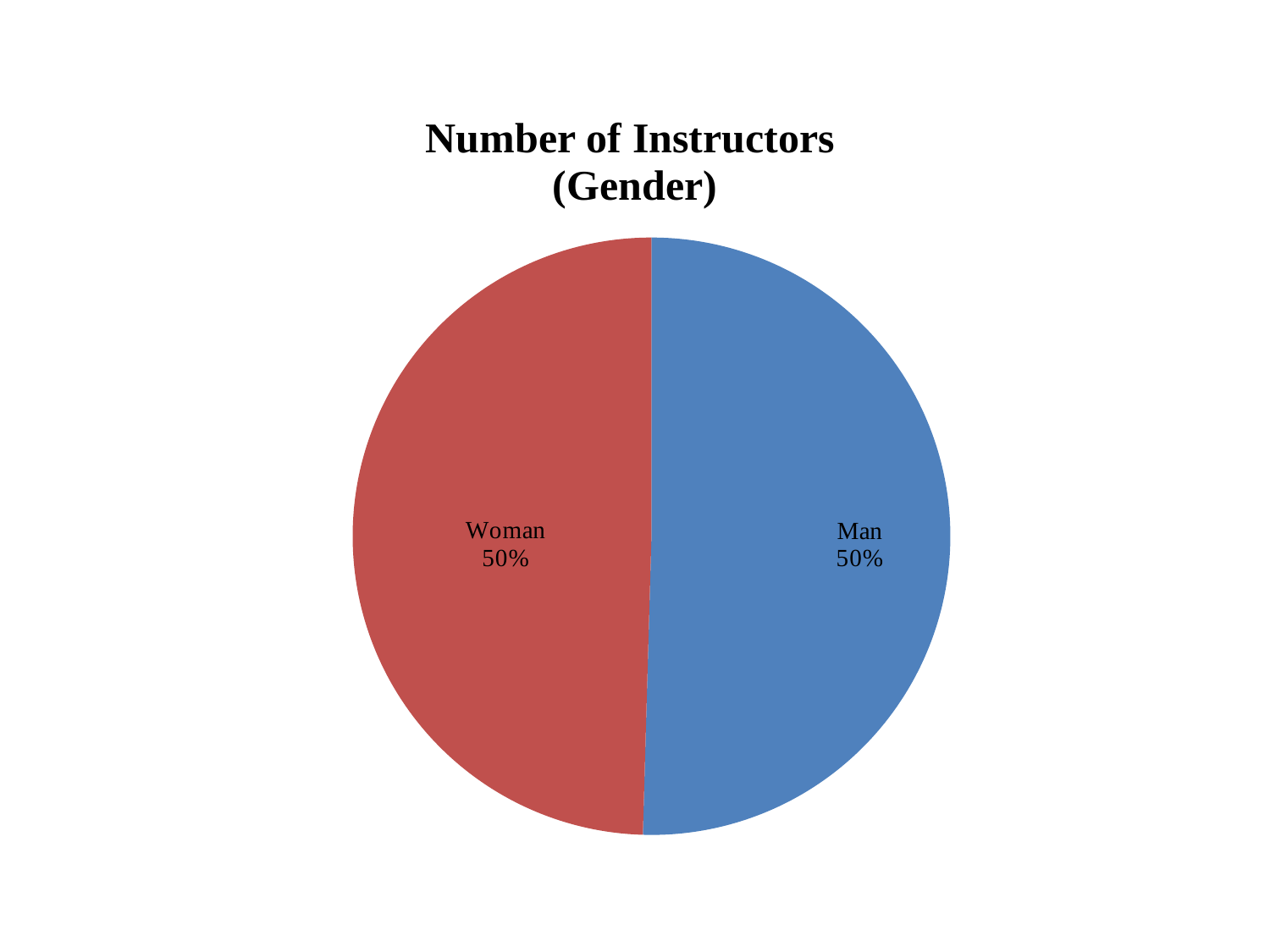
How many slices does the pie chart have? 2 What is the value shown for Man? 50% What is the difference between the Woman share and the Man share? 0% What colour is the Man slice? blue What share of the pie does the Man slice represent? 50% What is the title of the chart? Number of Instructors (Gender) What share of the pie does the Woman slice represent? 50% What kind of chart is shown on the slide? pie chart What is the value shown for Woman? 50% Is the value for Woman greater or less than 25%? greater